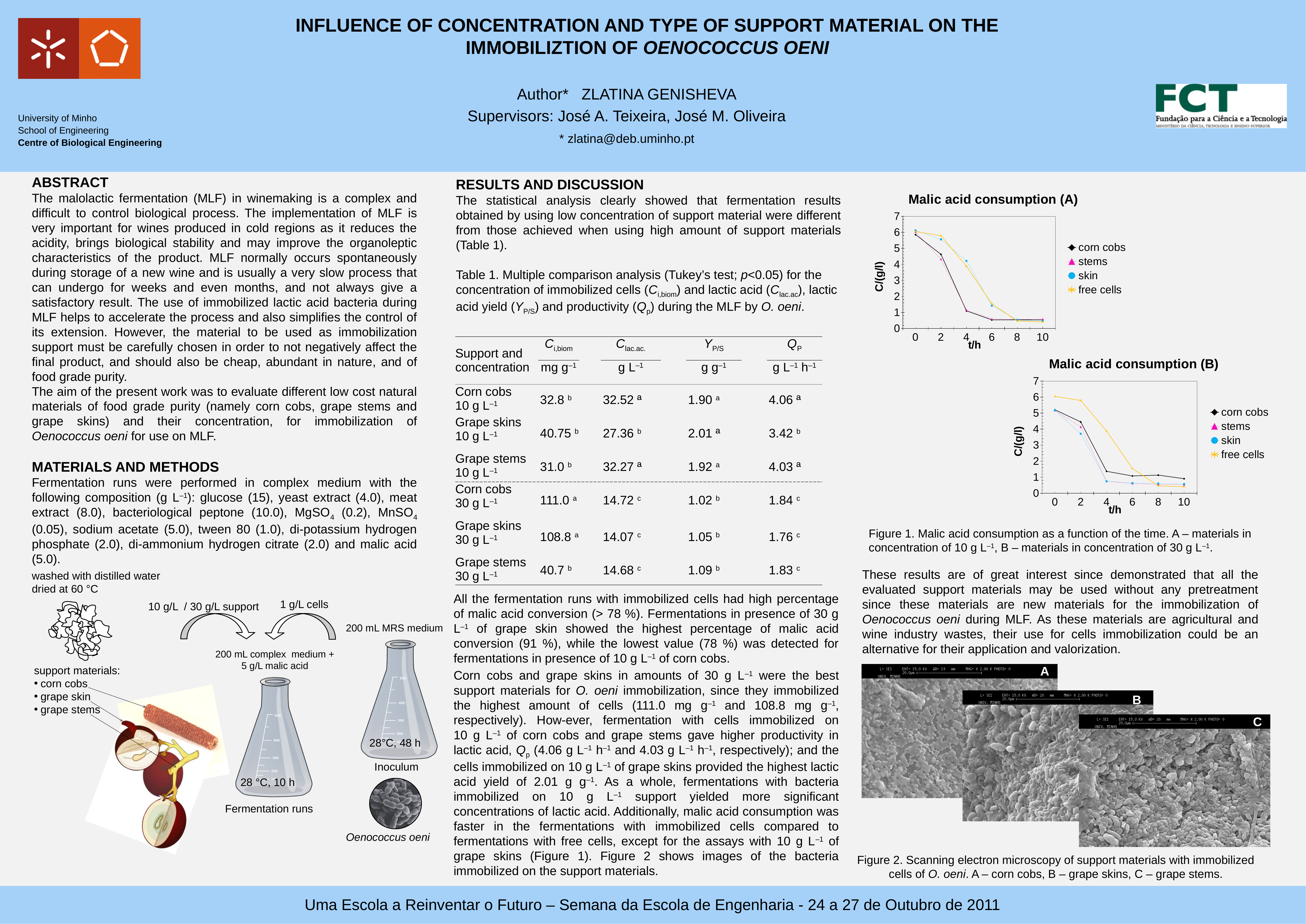
In "Malic acid consumption (A)", do the values rise or fall as time increases along the x axis? fall In "Malic acid consumption (B)", is the value for skin at t = 4 h greater or less than 3? less How many series does the legend of "Malic acid consumption (B)" list? 4 In "Malic acid consumption (A)", which is larger at t = 4 h, the value for free cells or the value for corn cobs? free cells Which series is shown with a star marker in the legend of "Malic acid consumption (B)"? free cells In "Malic acid consumption (B)", which series has the highest value at t = 4 h? free cells In "Malic acid consumption (A)", is the value for free cells at t = 4 h greater or less than 3? greater What kind of chart is "Malic acid consumption (A)"? line chart In "Malic acid consumption (B)", do the values rise or fall as time increases along the x axis? fall What is the label of the y axis in "Malic acid consumption (A)"? C/(g/l) In "Malic acid consumption (A)", is the value for corn cobs at t = 4 h greater or less than 3? less